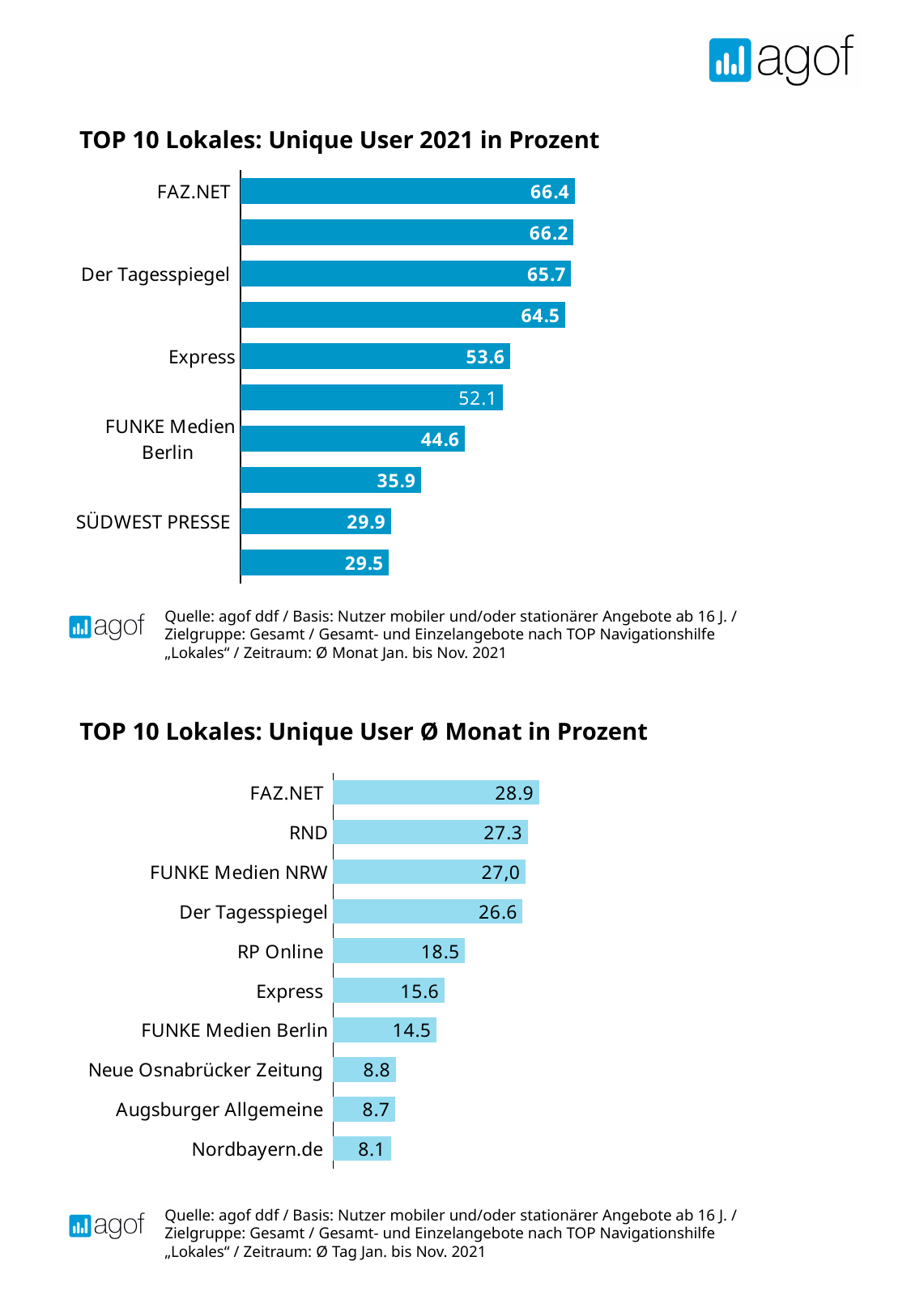
What kind of chart is 'TOP 10 Lokales: Unique User Ø Monat in Prozent'? Bar chart In the chart 'TOP 10 Lokales: Unique User Ø Monat in Prozent', what is the value for RP Online? 18.5 In the chart 'TOP 10 Lokales: Unique User Ø Monat in Prozent', which category has the highest value? FAZ.NET In the chart 'TOP 10 Lokales: Unique User 2021 in Prozent', how many bars are shown? 10 In the chart 'TOP 10 Lokales: Unique User Ø Monat in Prozent', which category has the lowest value? Nordbayern.de In the chart 'TOP 10 Lokales: Unique User 2021 in Prozent', what is the value for FAZ.NET? 66.4 In the chart 'TOP 10 Lokales: Unique User Ø Monat in Prozent', what is the difference between RND and Der Tagesspiegel? 0.7 In the chart 'TOP 10 Lokales: Unique User 2021 in Prozent', what is the value for SÜDWEST PRESSE? 29.9 In the chart 'TOP 10 Lokales: Unique User Ø Monat in Prozent', what is the value for Neue Osnabrücker Zeitung? 8.8 In the chart 'TOP 10 Lokales: Unique User 2021 in Prozent', what is the difference between Der Tagesspiegel and FUNKE Medien Berlin? 21.1 In the chart 'TOP 10 Lokales: Unique User 2021 in Prozent', what is the value for Express? 53.6 In the chart 'TOP 10 Lokales: Unique User Ø Monat in Prozent', which is larger, Express or FUNKE Medien Berlin? Express